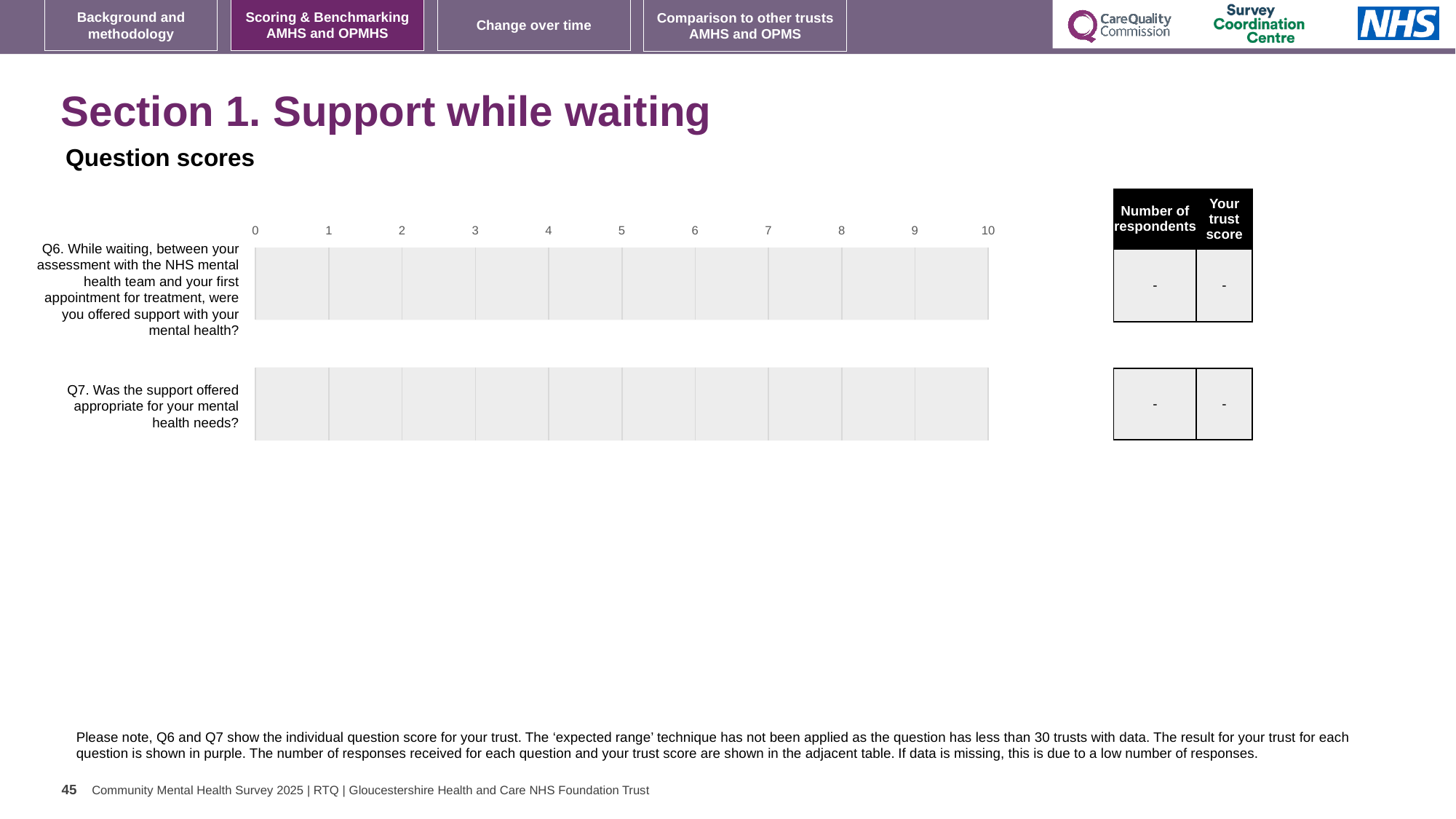
What is the 'Number of respondents' value shown in the table for Q7? - What is the highest value shown on the chart's x axis? 10 What is the section title above the chart? Section 1. Support while waiting Which question label appears first (at the top) on the chart? Q6. While waiting, between your assessment with the NHS mental health team and your first appointment for treatment, were you offered support with your mental health? Are any bars plotted for Q6 or Q7 on the chart? No How many questions (categories) are listed on the chart? 2 What is the 'Your trust score' value shown in the table for Q6? - What kind of chart is shown under 'Question scores'? Bar chart Which question label appears second (at the bottom) on the chart? Q7. Was the support offered appropriate for your mental health needs?